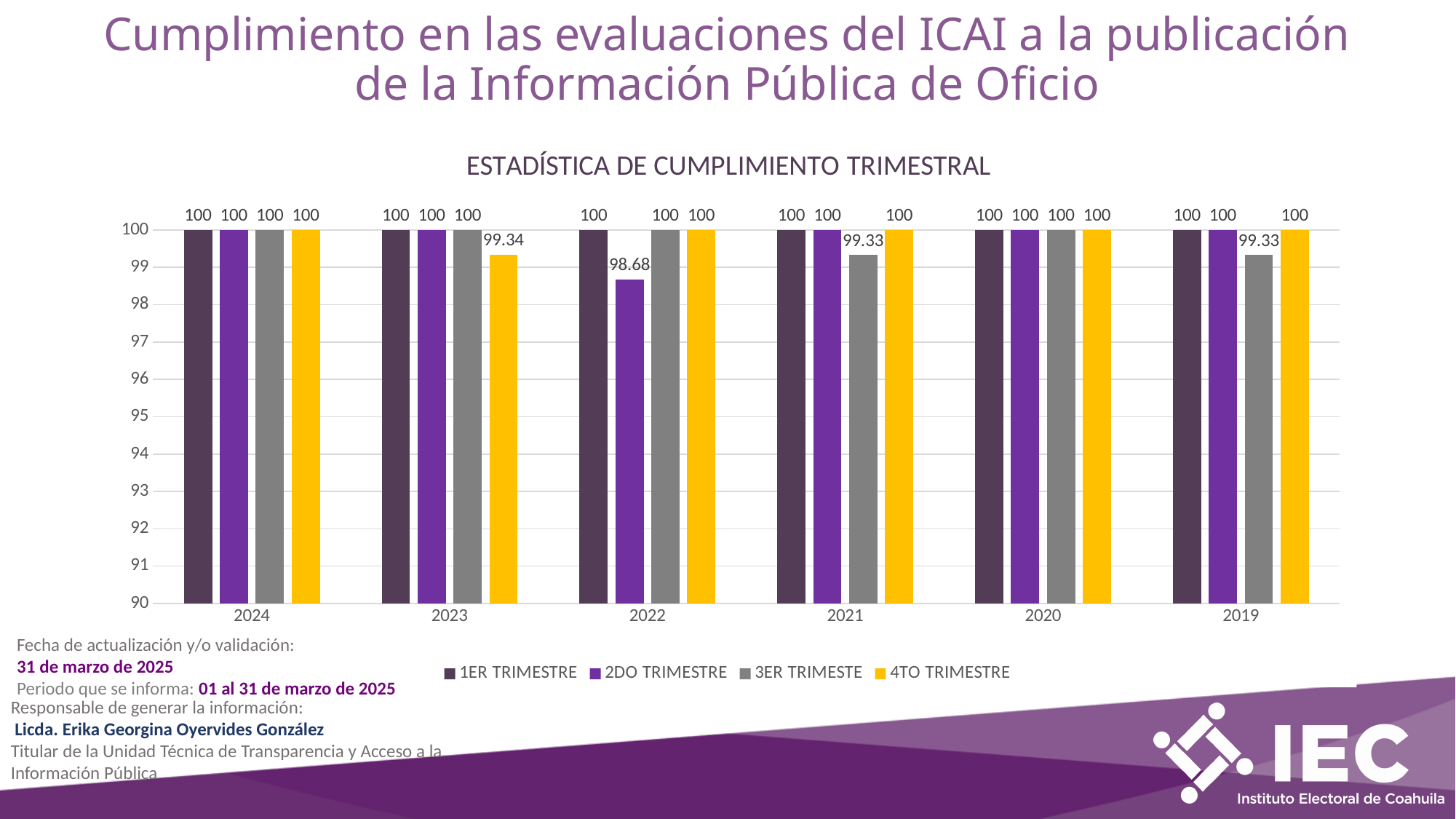
What is the value for 1ER TRIMESTRE in 2020? 100 What is the value for 2DO TRIMESTRE in 2022? 98.68 Which year has the lowest value for 2DO TRIMESTRE? 2022 What is the difference between the 1ER TRIMESTRE and 2DO TRIMESTRE values in 2022? 1.32 What kind of chart is shown on the slide? Bar chart Which is larger in 2023: the 3ER TRIMESTE value or the 4TO TRIMESTRE value? 3ER TRIMESTE Which quarter has the lowest value in 2019? 3ER TRIMESTE How many series does the legend list? 4 What is the value for 3ER TRIMESTE in 2021? 99.33 What is the value for 4TO TRIMESTRE in 2023? 99.34 How many years are shown on the x axis? 6 What is the title of the chart? ESTADÍSTICA DE CUMPLIMIENTO TRIMESTRAL